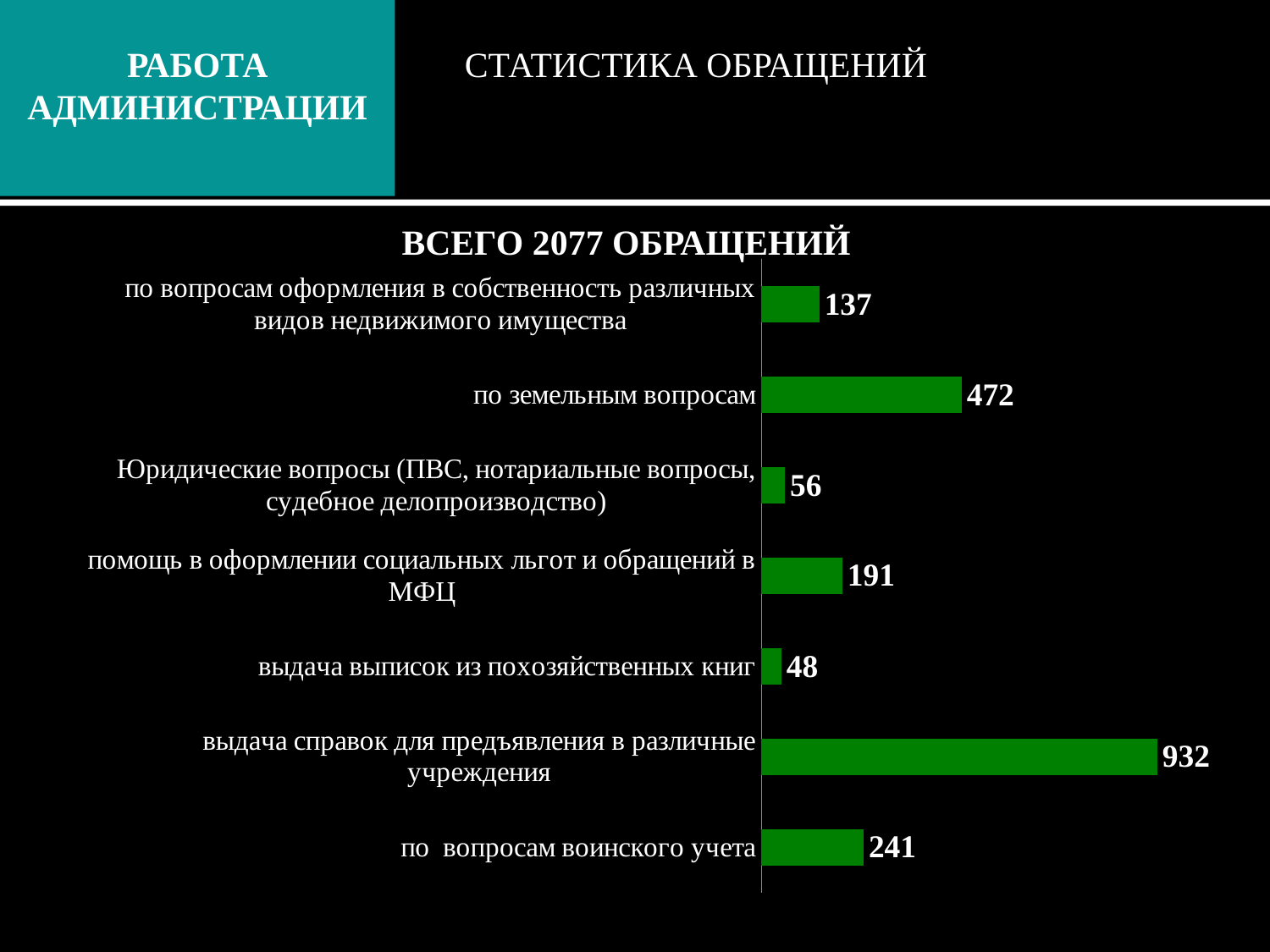
What is the value for 'по земельным вопросам'? 472 How many categories are shown in the chart? 7 What is the value for 'по вопросам воинского учета'? 241 Which category has the lowest value? выдача выписок из похозяйственных книг What is the difference between the values for 'помощь в оформлении социальных льгот и обращений в МФЦ' and 'по вопросам оформления в собственность различных видов недвижимого имущества'? 54 What kind of chart is shown on the slide? bar chart Which category has the highest value? выдача справок для предъявления в различные учреждения What colour are the bars in the chart? green What is the difference between the values for 'по земельным вопросам' and 'по вопросам воинского учета'? 231 Which is larger: the value for 'Юридические вопросы (ПВС, нотариальные вопросы, судебное делопроизводство)' or the value for 'выдача выписок из похозяйственных книг'? Юридические вопросы (ПВС, нотариальные вопросы, судебное делопроизводство) What is the value for 'выдача выписок из похозяйственных книг'? 48 What is the title of the chart? ВСЕГО 2077 ОБРАЩЕНИЙ